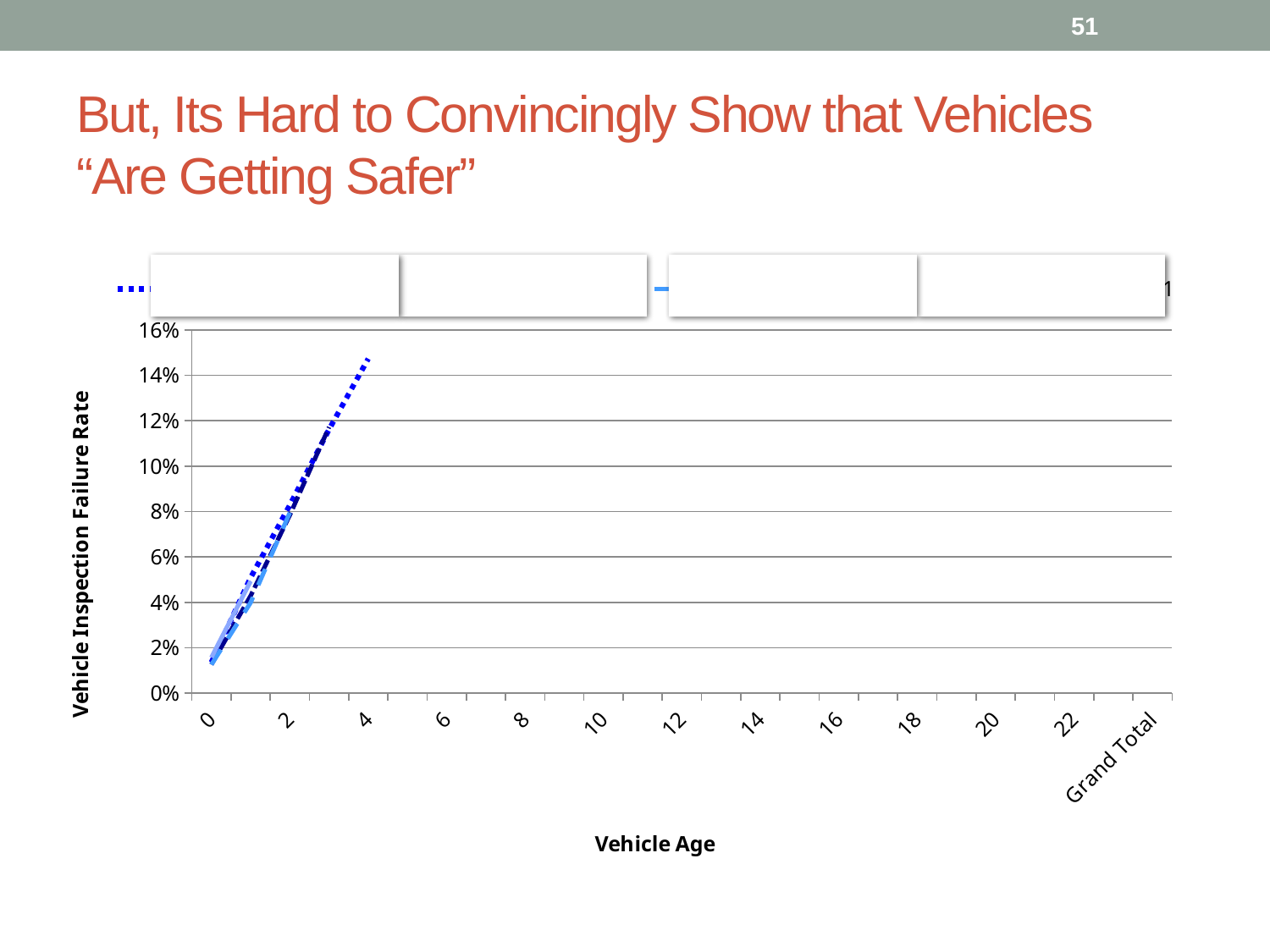
Is the highest plotted value on the chart greater or less than 12%? greater Is the failure rate at vehicle age 2 greater or less than 4%? greater What kind of chart is shown on the slide? line chart Do the plotted lines rise or fall as vehicle age increases from 0 to 4? rise What is the highest value shown on the vertical axis? 16% Is the highest plotted value on the chart greater or less than 16%? less What is the title of the vertical axis? Vehicle Inspection Failure Rate What is the title of the horizontal axis? Vehicle Age